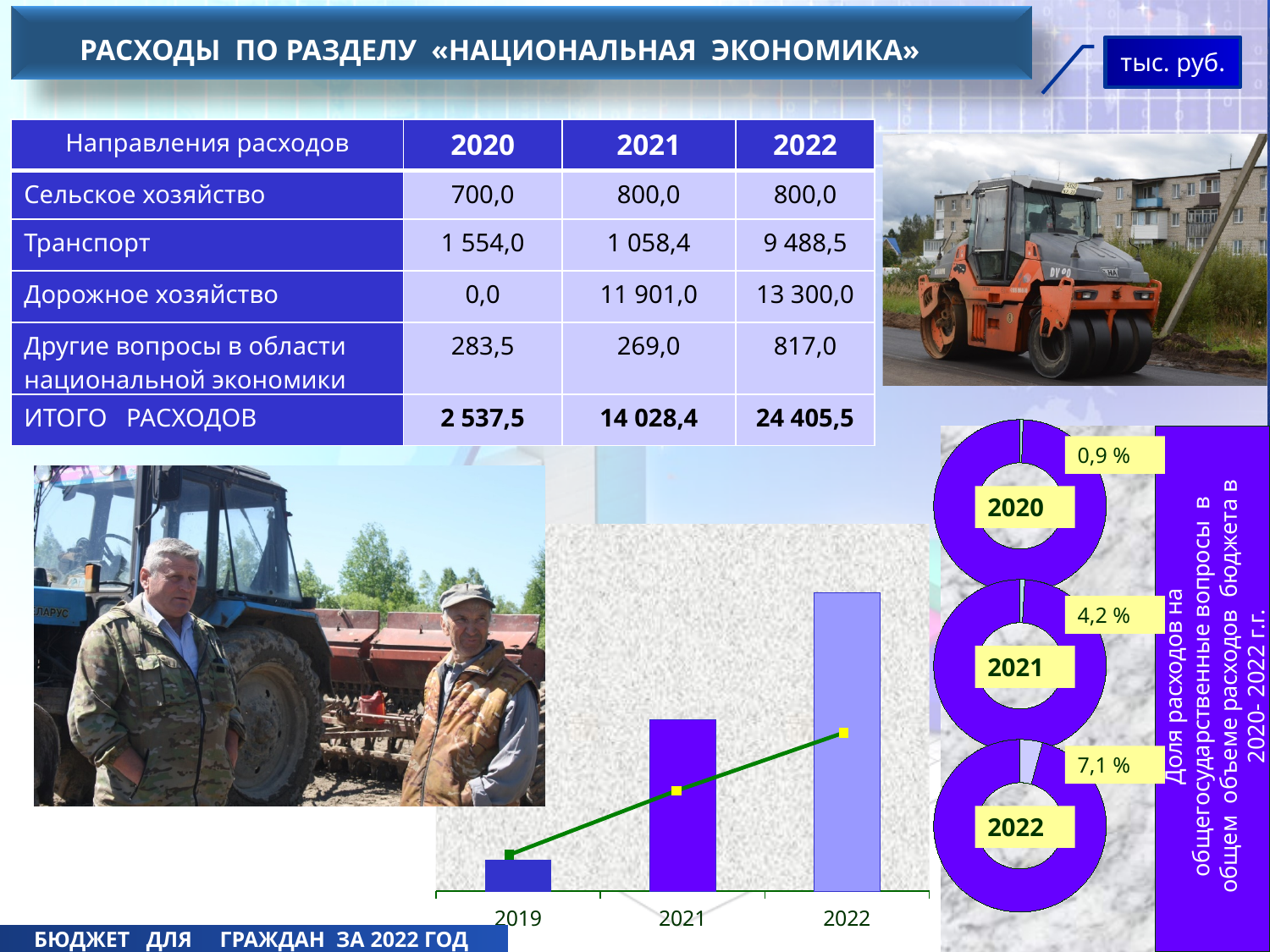
On the donut charts on the right, what share is shown for 2021? 4,2 % On the bar chart at the bottom centre, do the bars rise or fall from left to right? rise On the donut charts on the right, what share is shown for 2020? 0,9 % On the donut charts on the right, what is the difference between the 2022 share and the 2020 share? 6,2 % On the donut charts on the right, which year has the highest share? 2022 On the donut charts on the right, which year has the lowest share? 2020 On the donut charts on the right, what is the difference between the 2021 share and the 2020 share? 3,3 % On the donut charts on the right, is the share for 2021 larger or smaller than the share for 2022? smaller On the bar chart at the bottom centre, how many categories are on the x axis? 3 How many donut charts are shown on the right side of the slide? 3 On the donut charts on the right, what share is shown for 2022? 7,1 % What kind of chart is shown at the bottom centre of the slide? bar chart